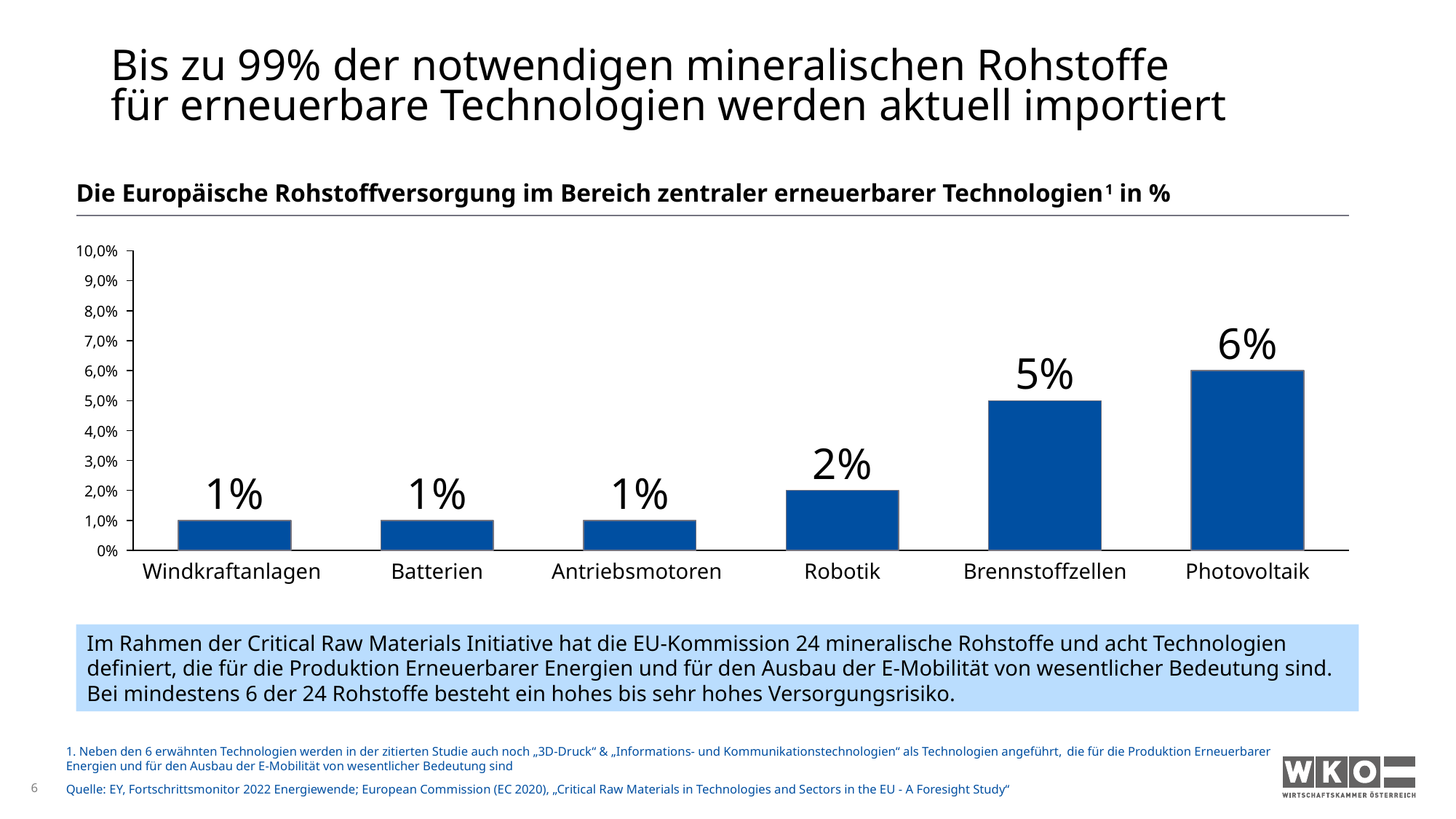
Which is larger, the value for Brennstoffzellen or the value for Robotik? Brennstoffzellen What is the value for Robotik? 2% Is the value for Brennstoffzellen greater or less than 3,0%? greater What is the value for Brennstoffzellen? 5% What is the title of the chart? Die Europäische Rohstoffversorgung im Bereich zentraler erneuerbarer Technologien in % What is the difference between the values for Photovoltaik and Robotik? 4% What is the value for Windkraftanlagen? 1% Which category has the highest value? Photovoltaik What is the value for Photovoltaik? 6% What is the difference between the values for Brennstoffzellen and Batterien? 4% What kind of chart is shown on the slide? bar chart How many categories are shown on the x axis? 6